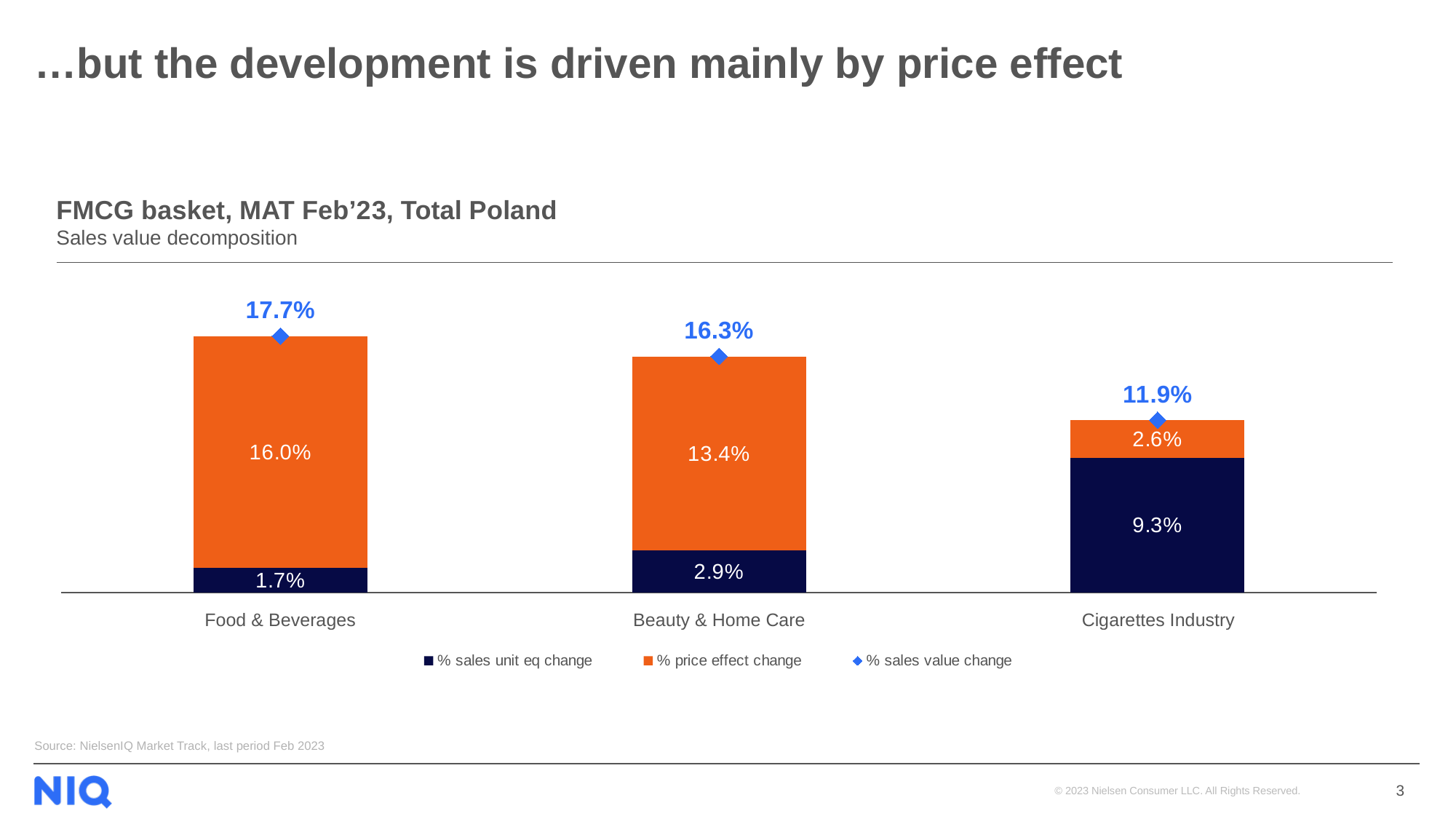
What is the % sales value change for Beauty & Home Care? 16.3% How many series does the legend list? 3 What is the % sales unit eq change for Cigarettes Industry? 9.3% Which category has the highest % sales value change? Food & Beverages Which is larger: the % sales unit eq change for Cigarettes Industry or for Food & Beverages? Cigarettes Industry What kind of chart is shown on the slide? Stacked bar chart Which category has the lowest % price effect change? Cigarettes Industry What is the % price effect change for Food & Beverages? 16.0% What is the subtitle of the chart below 'FMCG basket, MAT Feb'23, Total Poland'? Sales value decomposition What is the % sales unit eq change for Beauty & Home Care? 2.9% What is the difference between the % price effect change for Food & Beverages and Beauty & Home Care? 2.6% How many categories are shown on the x axis? 3